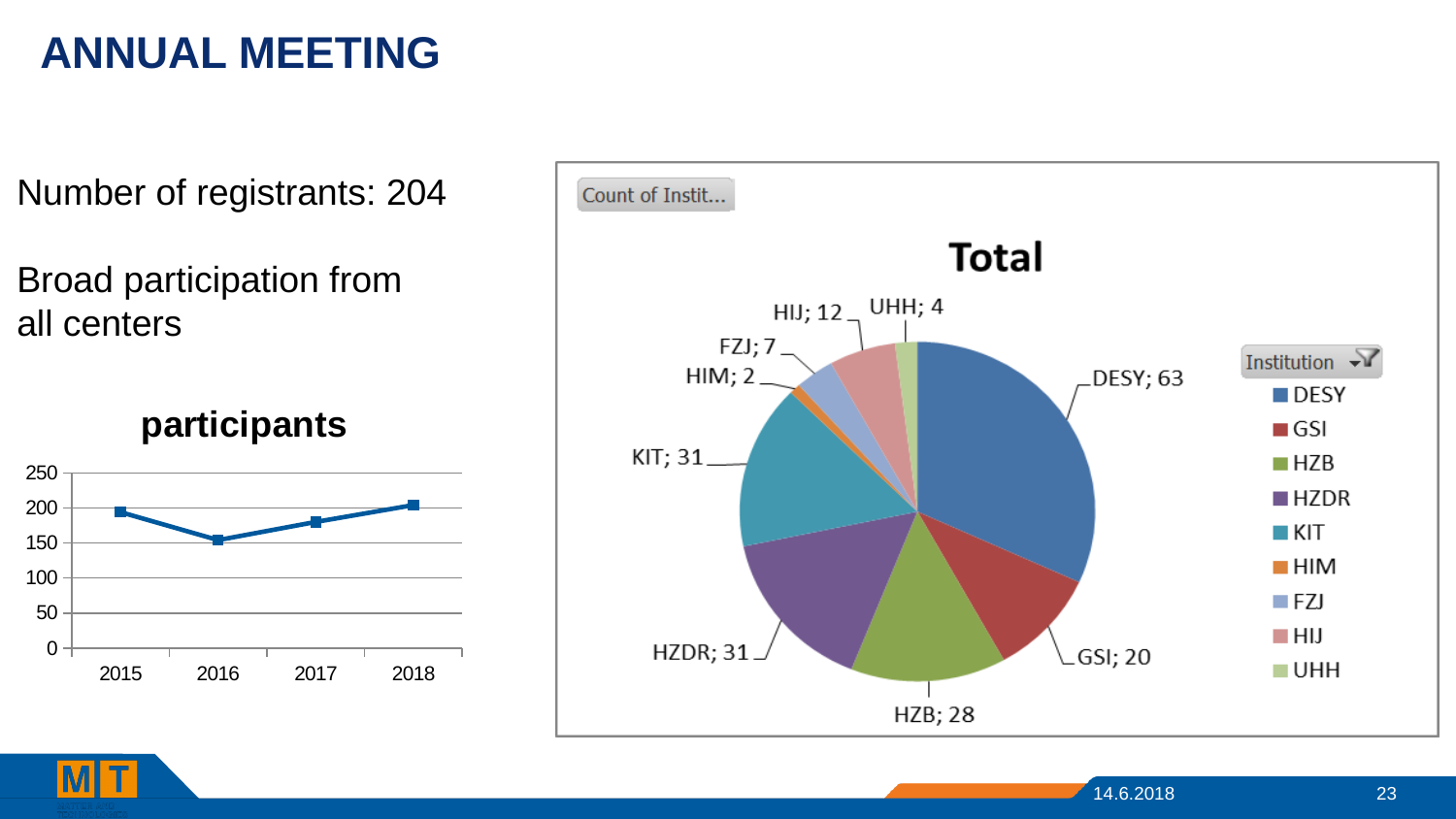
On the pie chart titled "Total", what is the value for DESY? 63 On the chart titled "participants", is the value for 2016 greater or less than 200? less On the pie chart titled "Total", how many institutions are shown in the legend? 9 On the chart titled "participants", do the values rise or fall from 2016 to 2018? rise On the pie chart titled "Total", which institution has the largest slice? DESY On the pie chart titled "Total", what is the value for HZB? 28 On the pie chart titled "Total", which institution has the smallest slice? HIM On the chart titled "participants", which year has the lowest value? 2016 On the pie chart titled "Total", what is the difference between the values for DESY and GSI? 43 What kind of chart is the chart titled "participants"? Line chart On the pie chart titled "Total", what colour is the DESY slice? Blue On the pie chart titled "Total", which is larger, the value for HIJ or the value for FZJ? HIJ